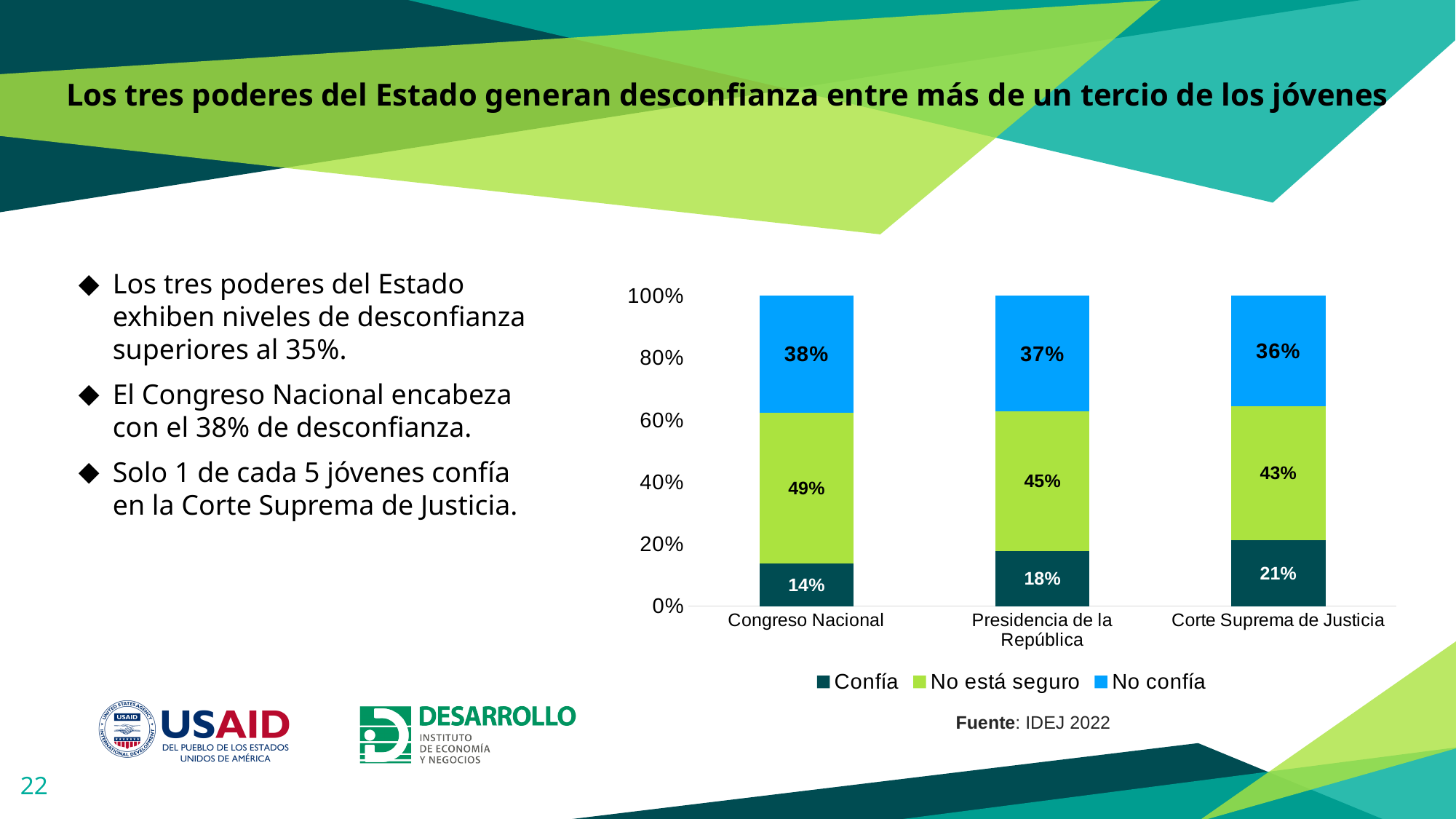
How many series does the legend list? 3 What is the 'No confía' value for Congreso Nacional? 38% What is the 'Confía' value for Corte Suprema de Justicia? 21% Do the 'No confía' values rise or fall from Congreso Nacional to Corte Suprema de Justicia? Fall How many categories are shown on the x axis? 3 Which is larger, the 'Confía' value for Presidencia de la República or for Congreso Nacional? Presidencia de la República What is the 'No está seguro' value for Presidencia de la República? 45% What kind of chart is shown on the slide? Stacked bar chart What is the source cited below the chart? IDEJ 2022 Which category has the highest 'Confía' value? Corte Suprema de Justicia Which category has the lowest 'No está seguro' value? Corte Suprema de Justicia What is the difference between the 'No está seguro' values for Congreso Nacional and Corte Suprema de Justicia? 6%